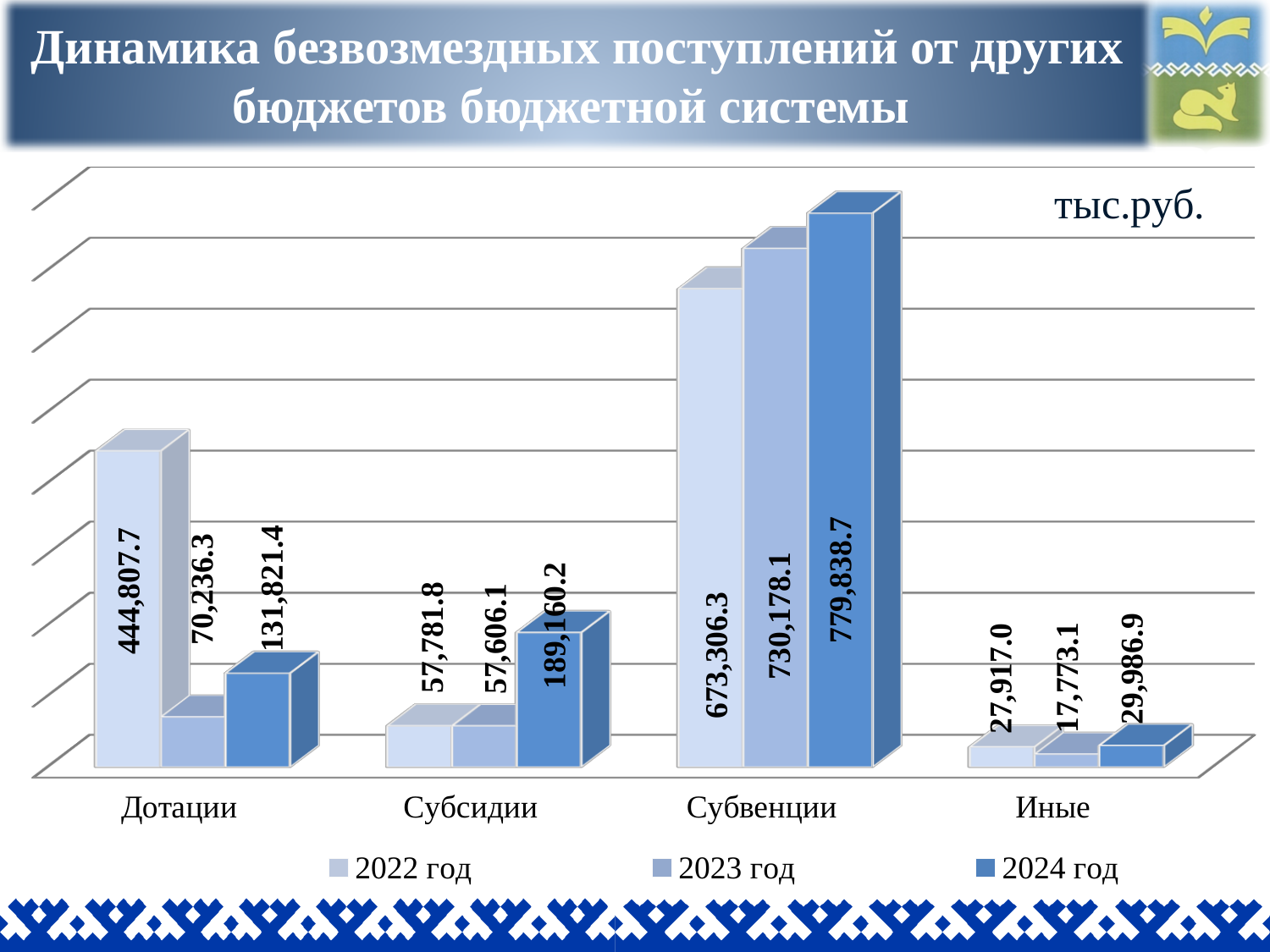
What is the difference between the 2022 год and 2024 год values for Дотации? 312,986.3 How many series does the legend list? 3 What is the value for Дотации in 2022 год? 444,807.7 Which is larger for Дотации: the 2023 год value or the 2024 год value? 2024 год Do the values for Субвенции rise or fall from 2022 год to 2024 год? rise How many categories are shown on the x axis? 4 Which category has the lowest value in 2022 год? Иные What is the value for Субвенции in 2024 год? 779,838.7 What is the difference between the 2024 год and 2023 год values for Субвенции? 49,660.6 What is the value for Иные in 2023 год? 17,773.1 Which category has the highest value in 2024 год? Субвенции What is the value for Субсидии in 2024 год? 189,160.2